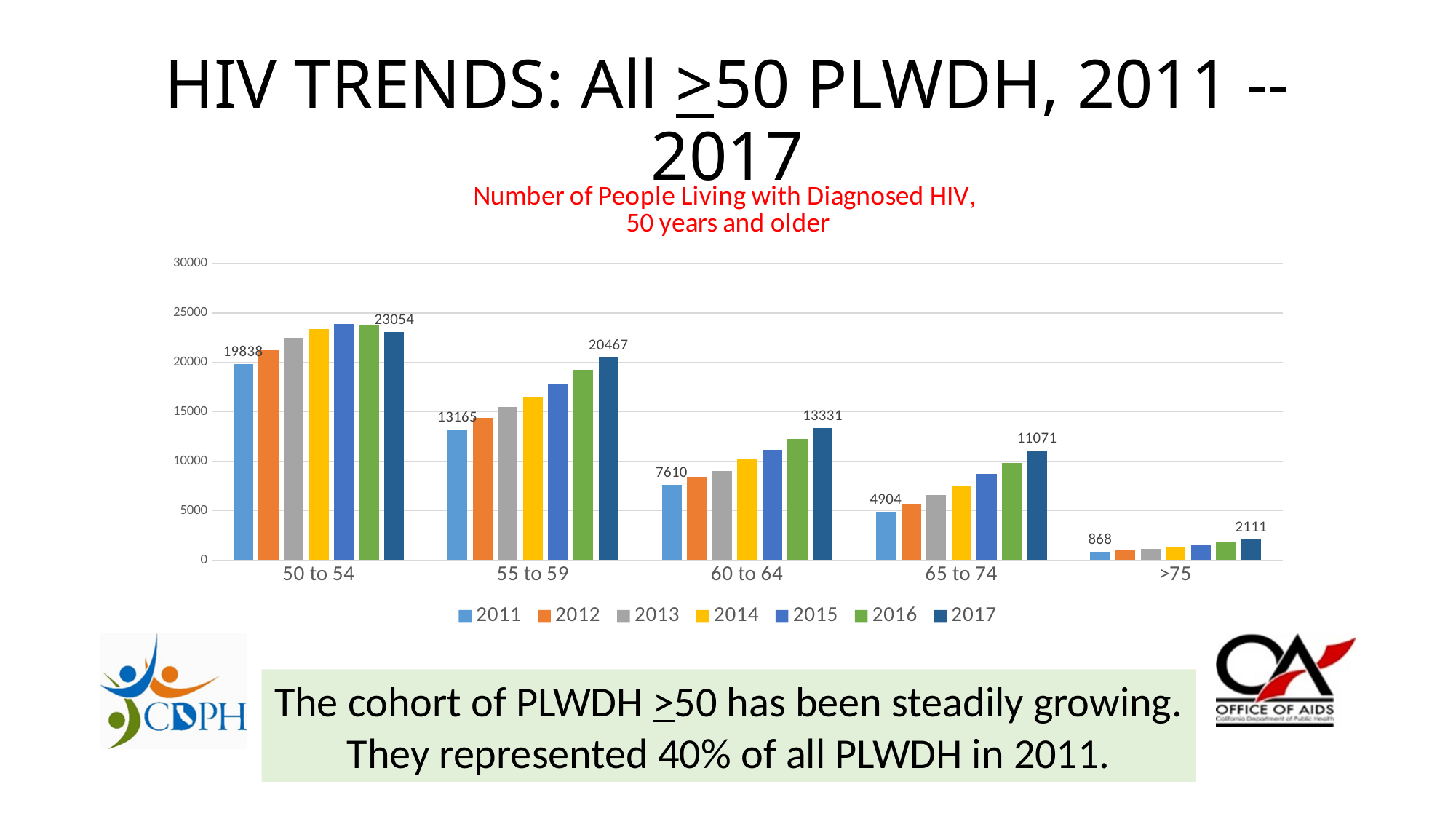
How many age groups are shown on the x axis? 5 How many years does the legend list? 7 Which age group has the highest value for 2017? 50 to 54 Do the values for the 55 to 59 age group rise or fall from 2011 to 2017? rise By how much did the 65 to 74 age group grow from 2011 to 2017? 6167 What is the difference between the 2017 and 2011 values for the 60 to 64 age group? 5721 What is the value for 2011 in the >75 age group? 868 What is the value for 2017 in the 55 to 59 age group? 20467 Which age group has the lowest value for 2011? >75 What is the value for 2011 in the 50 to 54 age group? 19838 Is the value for 2014 in the 50 to 54 age group greater or less than 20000? greater Which is larger: the 2017 value for 55 to 59 or the 2011 value for 50 to 54? 2017 value for 55 to 59